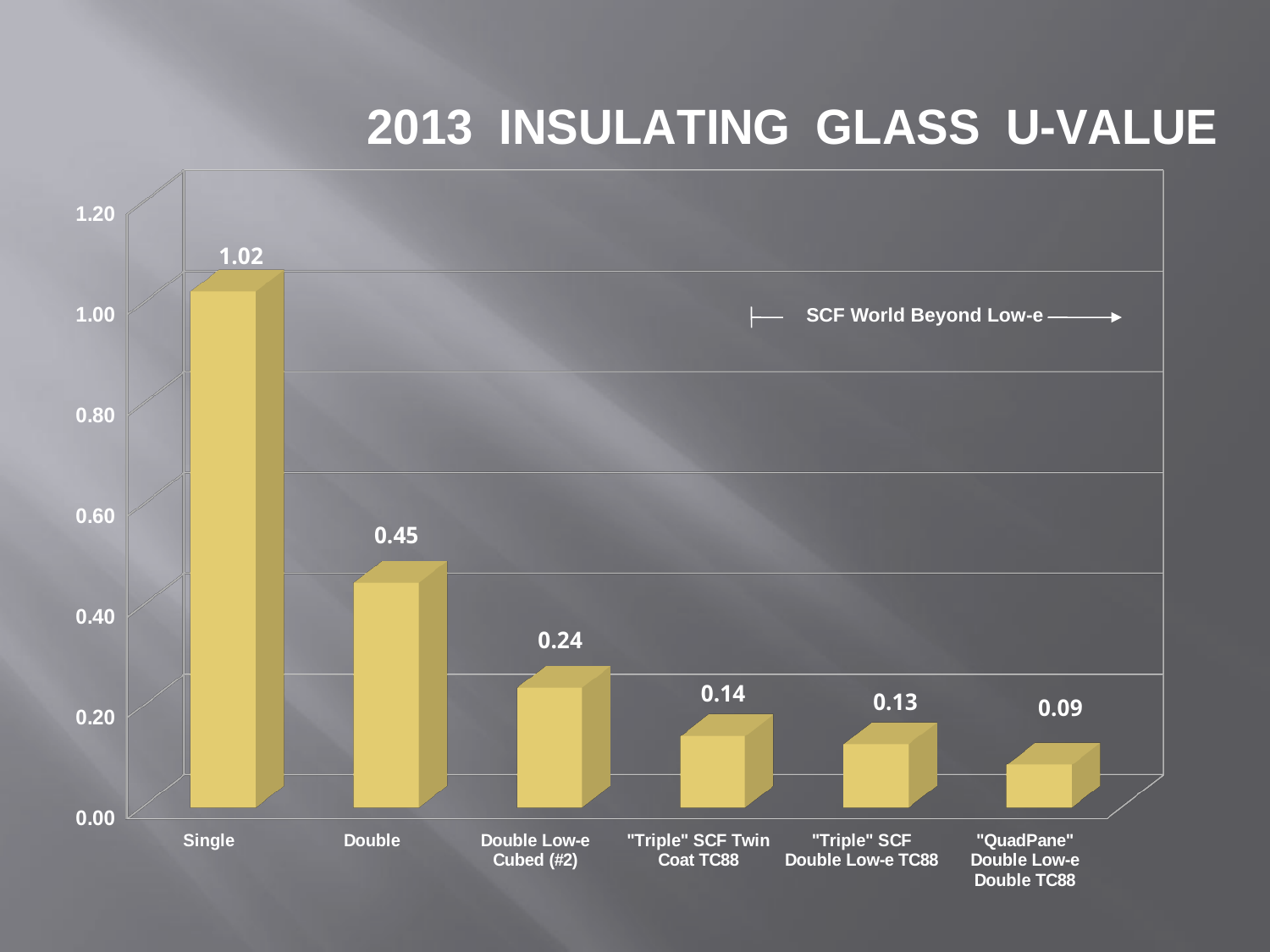
Which has a larger U-value, Double or Double Low-e Cubed (#2)? Double Which category has the lowest U-value? "QuadPane" Double Low-e Double TC88 What is the U-value shown for Double glass? 0.45 What is the difference between the U-values for Single and Double glass? 0.57 What is the difference between the U-values for Double Low-e Cubed (#2) and "Triple" SCF Twin Coat TC88? 0.10 Do the U-values rise or fall from left to right along the x axis? fall What kind of chart is shown on the slide? bar chart Which category has the highest U-value? Single What is the U-value shown for "QuadPane" Double Low-e Double TC88? 0.09 How many categories are shown on the x axis? 6 Is the U-value for Double glass greater or less than 0.40? greater What is the U-value shown for Single glass? 1.02